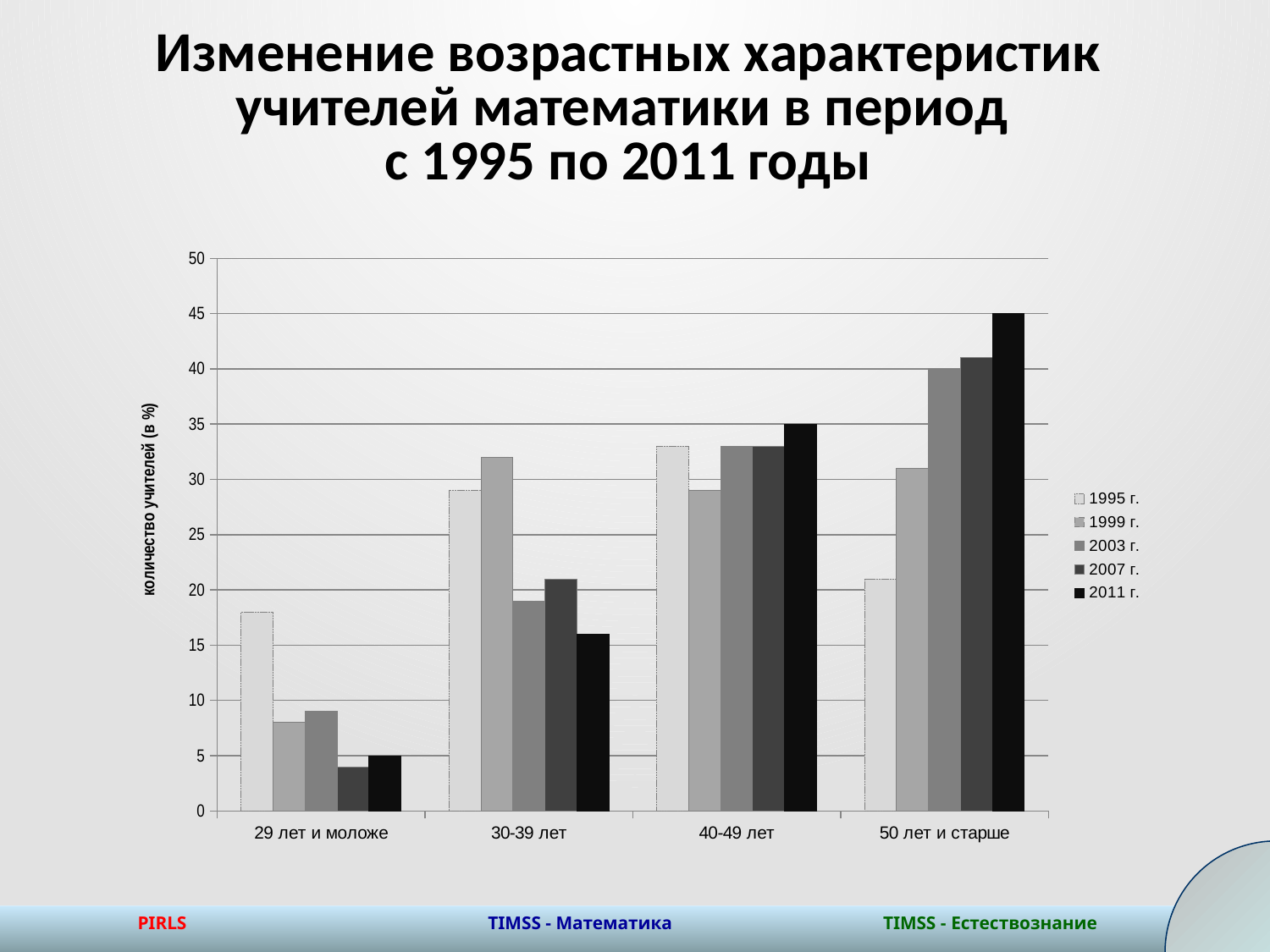
Is the value for 2011 г. in the 30-39 лет category greater or less than 20? less What is the value for 2003 г. in the 50 лет и старше category? 40 Do the values for 2011 г. rise or fall across the age categories from 29 лет и моложе to 50 лет и старше? rise How many age categories are shown on the x axis? 4 In the 30-39 лет category, which is larger: the value for 1999 г. or the value for 2007 г.? 1999 г. How many series does the legend list? 5 Is the value for 1995 г. in the 29 лет и моложе category greater or less than 15? greater What is the value for 2011 г. in the 40-49 лет category? 35 Which year has the highest value in the 50 лет и старше category? 2011 г. Which year has the lowest value in the 29 лет и моложе category? 2007 г. What kind of chart is shown on the slide? bar chart What is the value for 2011 г. in the 50 лет и старше category? 45